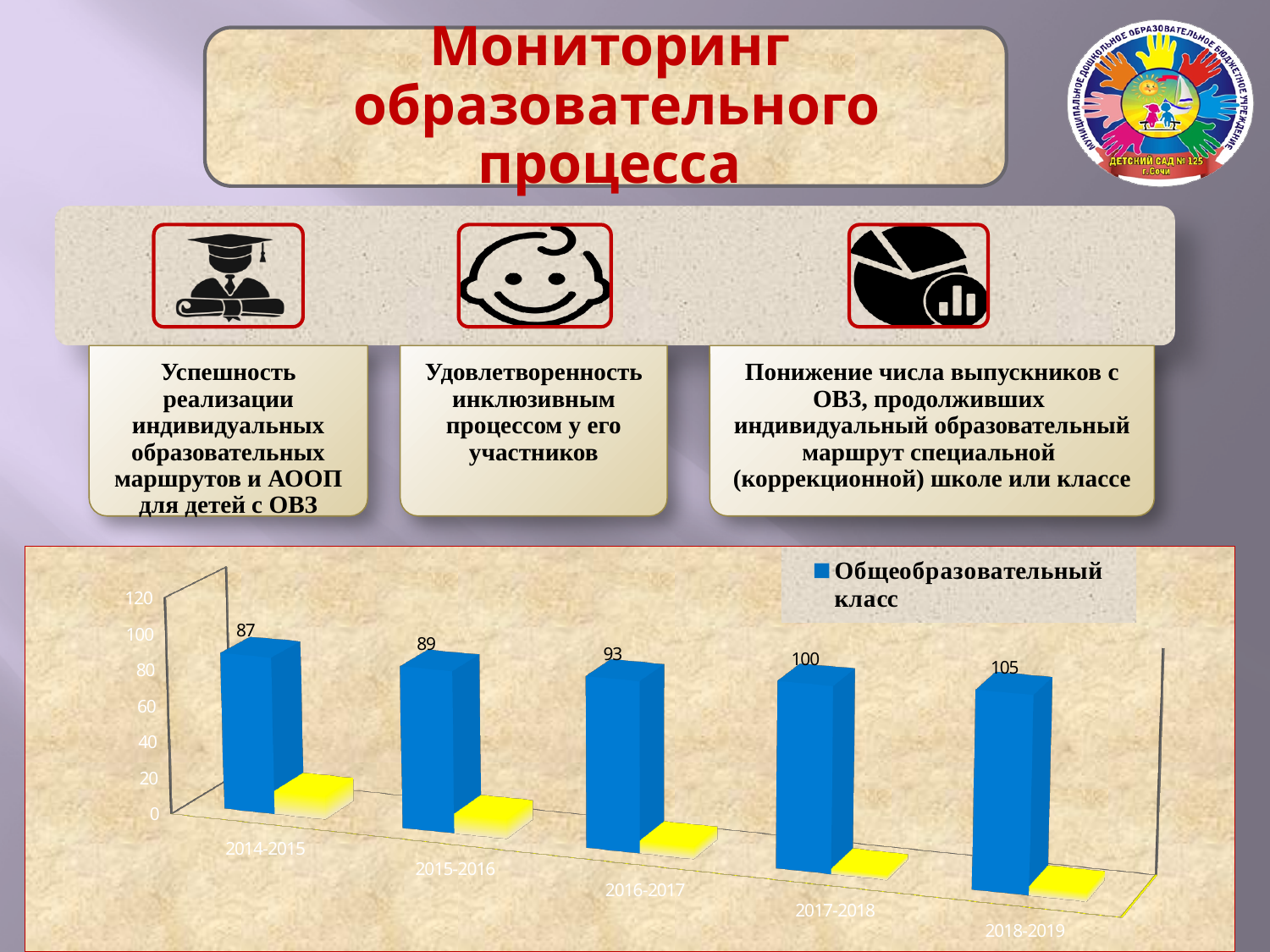
What is the value of the blue bar for 2014-2015? 87 Which is larger, the blue bar for 2015-2016 or for 2017-2018? 2017-2018 Is the yellow bar for 2014-2015 greater or less than 40? less What is the value of the blue bar for 2016-2017? 93 What is the difference between the blue bar values for 2018-2019 and 2014-2015? 18 How many year categories are shown on the x axis? 5 Which year has the highest value for the blue series? 2018-2019 What kind of chart is shown on the slide? bar chart Which year has the lowest value for the blue series? 2014-2015 Do the blue bar values rise or fall from 2014-2015 to 2018-2019? rise How many series does the legend list? 1 What is the value of the blue bar for 2018-2019? 105